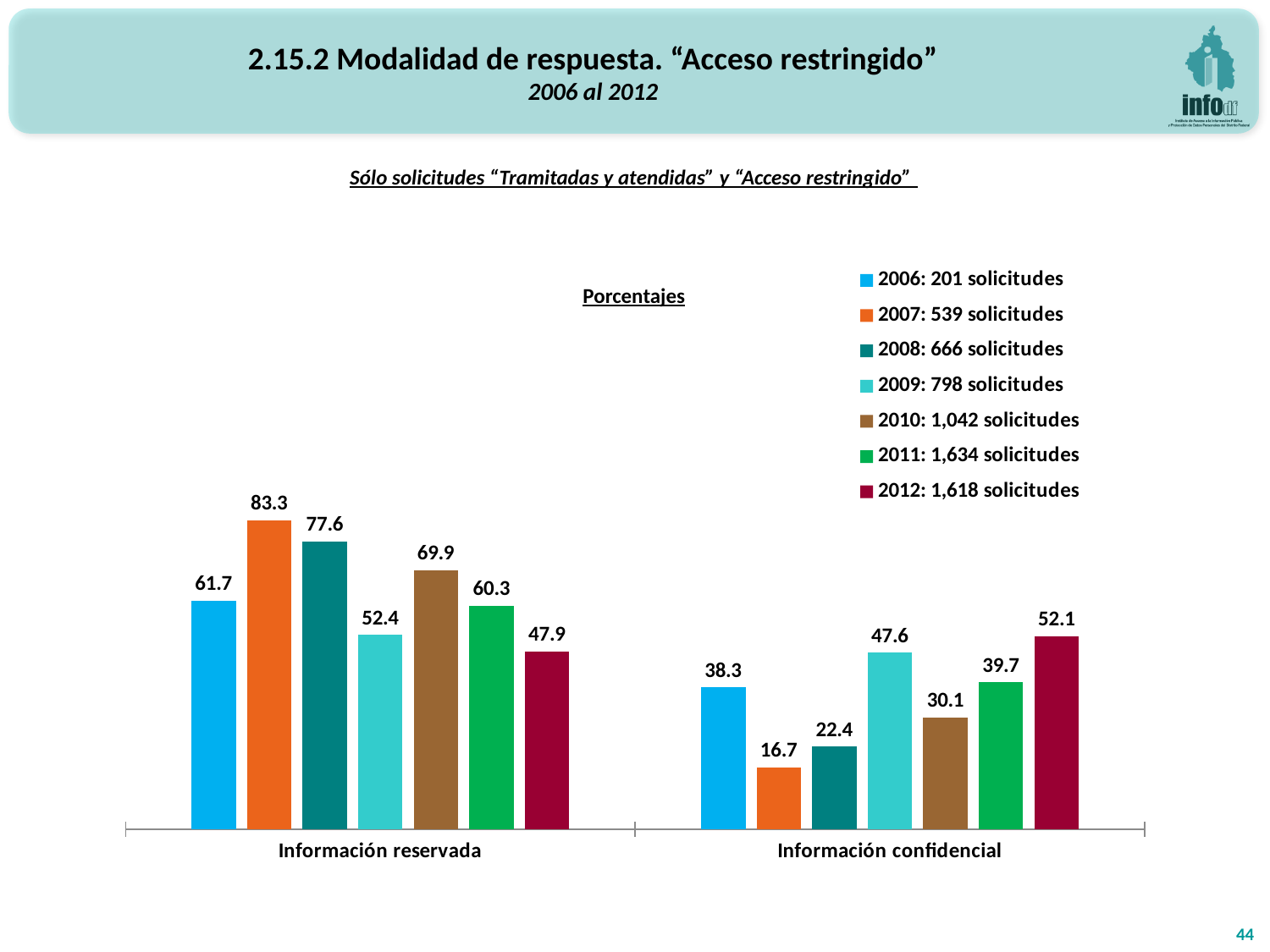
What is the difference between the 2009 and 2008 values in the Información confidencial category? 25.2 How many categories are shown on the x axis? 2 According to the legend, how many solicitudes were there in 2011? 1,634 solicitudes Which is larger: the 2010 value for Información reservada or the 2010 value for Información confidencial? Información reservada Which year has the lowest value in the Información confidencial category? 2007 Which year has the highest value in the Información reservada category? 2007 What is the value for 2007 in the Información reservada category? 83.3 What is the difference between the 2007 and 2012 values in the Información reservada category? 35.4 What is the value for 2009 in the Información reservada category? 52.4 What kind of chart is shown on the slide? Bar chart What is the value for 2012 in the Información confidencial category? 52.1 How many series does the legend list? 7